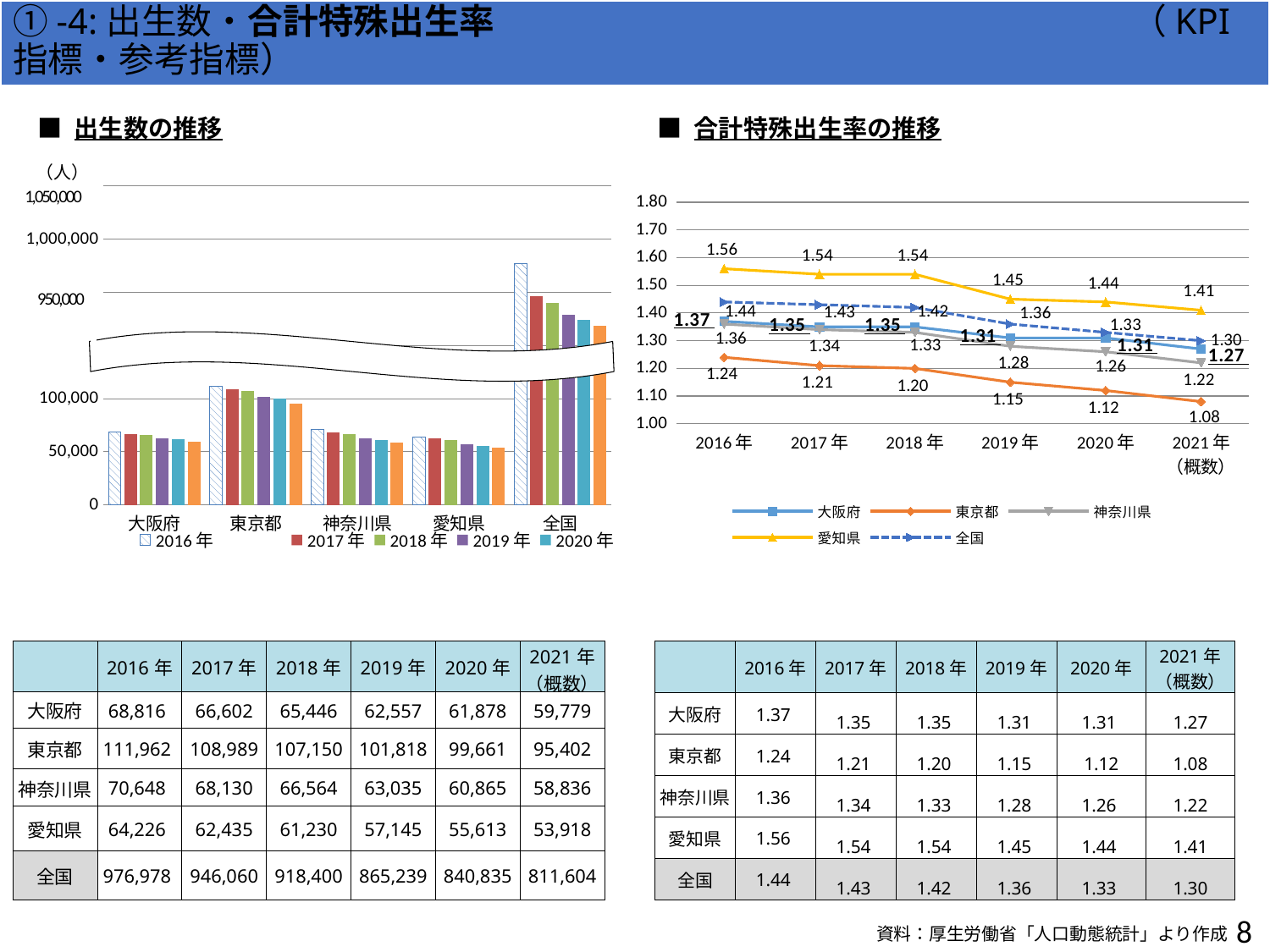
In the 合計特殊出生率の推移 chart, does the value for 大阪府 rise or fall from 2016年 to 2021年（概数）? fall In the 合計特殊出生率の推移 chart, which series has the lowest value in 2021年（概数）? 東京都 In the 合計特殊出生率の推移 chart, which series has the highest value in 2016年? 愛知県 In the 出生数の推移 chart, which category has the highest values? 全国 What kind of chart is the 合計特殊出生率の推移 chart on the right? line chart In the 合計特殊出生率の推移 chart, what is the difference between 愛知県 and 東京都 in 2016年? 0.32 What kind of chart is the 出生数の推移 chart on the left? bar chart How many series does the legend of the 合計特殊出生率の推移 chart list? 5 In the 合計特殊出生率の推移 chart, what is the value for 愛知県 in 2016年? 1.56 In the 出生数の推移 chart, is the 2016年 value for 東京都 greater or less than 100,000? greater In the 合計特殊出生率の推移 chart, what is the value for 全国 in 2018年? 1.42 In the 合計特殊出生率の推移 chart, what is the value for 東京都 in 2021年（概数）? 1.08